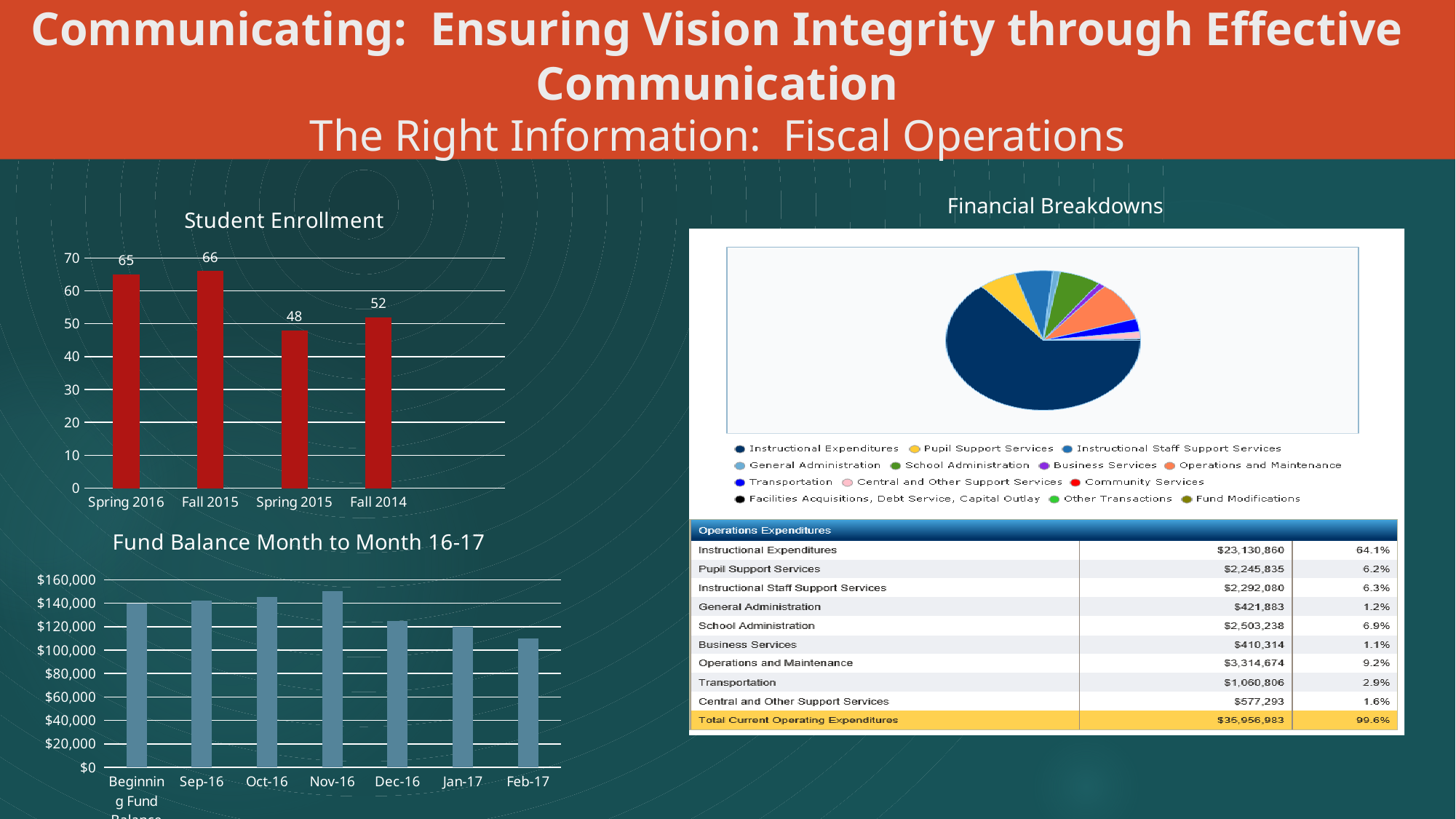
In the Student Enrollment chart, what is the enrollment for Spring 2016? 65 In the Student Enrollment chart, which term has the highest enrollment? Fall 2015 In the Fund Balance Month to Month 16-17 chart, which month has the highest fund balance? Nov-16 In the Financial Breakdowns pie chart, what share of the pie is Instructional Expenditures? 64.1% In the Fund Balance Month to Month 16-17 chart, is the value for Feb-17 greater or less than $120,000? less In the Financial Breakdowns pie chart, how many categories does the legend list? 13 In the Student Enrollment chart, what is the difference between the Fall 2015 and Spring 2015 values? 18 In the Student Enrollment chart, how many terms are shown? 4 In the Student Enrollment chart, which term has the lowest enrollment? Spring 2015 In the Fund Balance Month to Month 16-17 chart, do the values rise or fall from Nov-16 to Feb-17? Fall In the Fund Balance Month to Month 16-17 chart, is the value for Nov-16 greater or less than $140,000? greater What kind of chart is the Student Enrollment chart? Bar chart